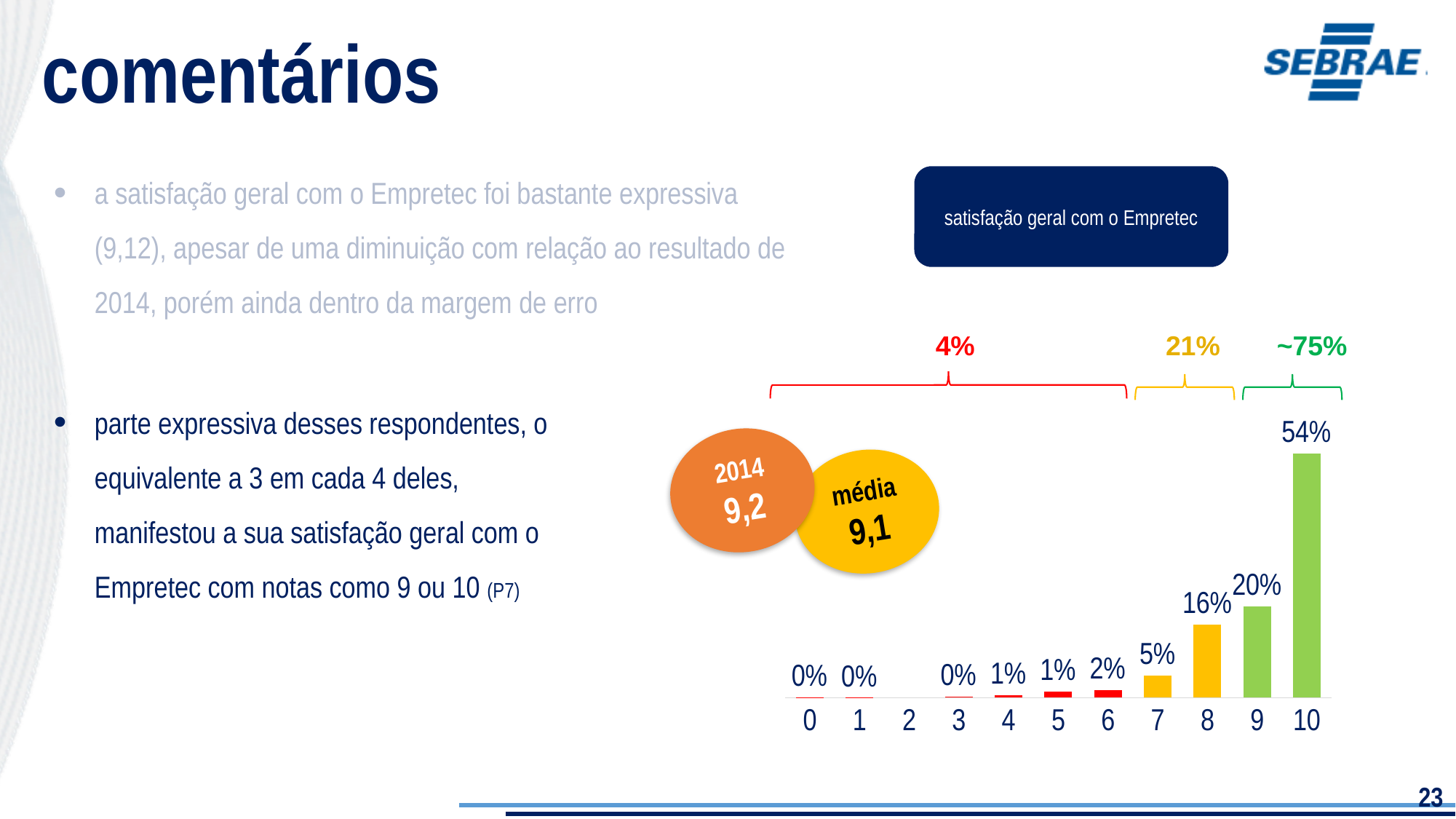
What is the title shown above the chart? satisfação geral com o Empretec What is the value for score 8 in the chart? 16% What is the value for score 10 in the chart? 54% What is the difference between the values for score 10 and score 9? 34 percentage points What is the value for score 7 in the chart? 5% What is the value for score 6 in the chart? 2% What kind of chart is shown on the slide? Bar chart Which has a larger value, score 8 or score 9? 9 What is the value for score 9 in the chart? 20% Which score has the highest value in the chart? 10 How many score categories are shown on the x axis of the chart? 11 Do the values generally rise or fall as the score increases from 0 to 10? Rise